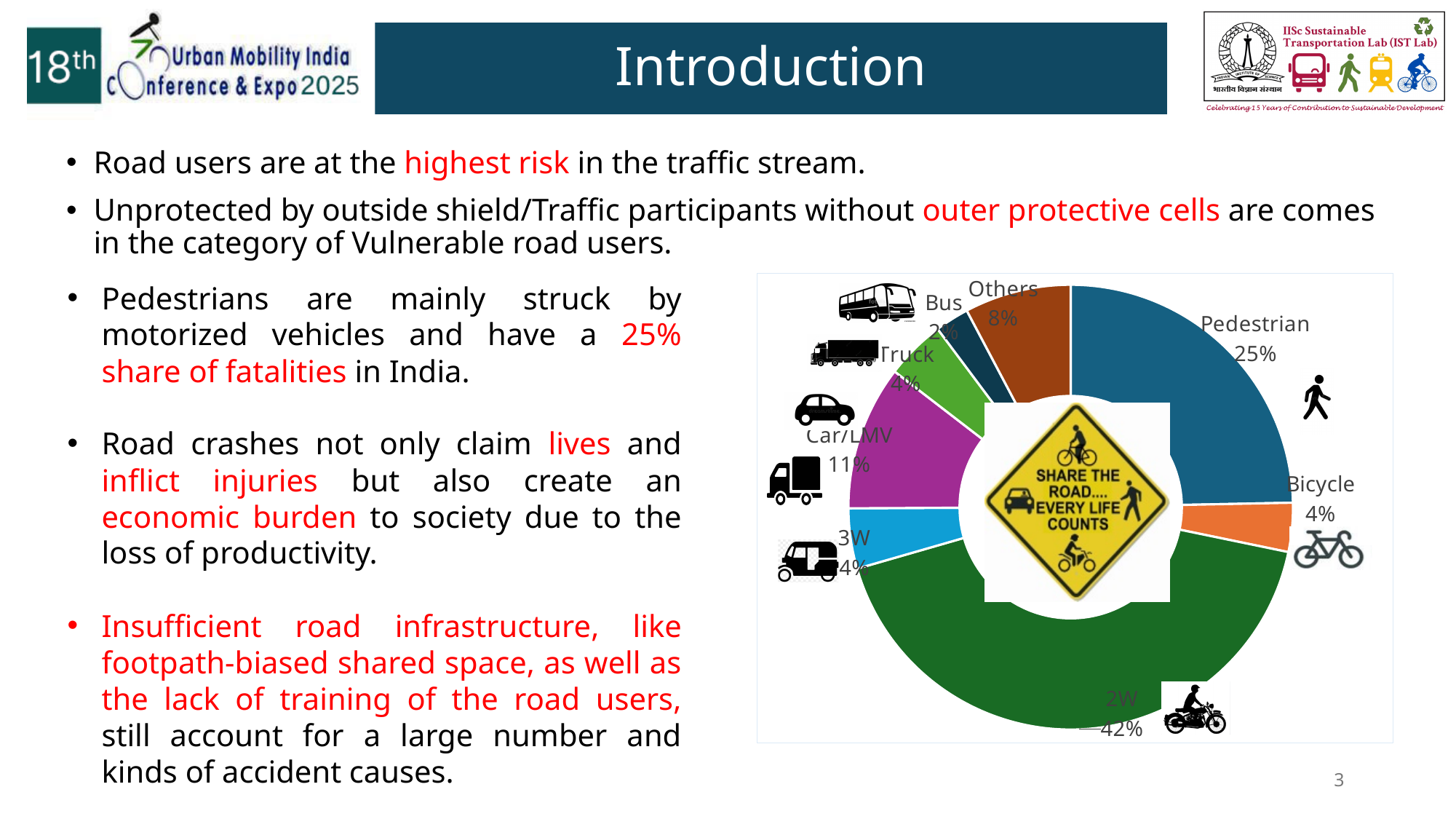
What share of fatalities does the Pedestrian slice of the pie chart show? 25% What percentage is shown for Bicycle in the pie chart? 4% Which has a larger share in the pie chart, Car/LMV or Others? Car/LMV Which category has the largest slice in the pie chart? 2W What percentage is shown for the 2W slice of the pie chart? 42% What percentage is shown for Bus in the pie chart? 2% By how many percentage points does the 2W share exceed the Pedestrian share in the pie chart? 17% How many categories are shown in the pie chart? 8 What percentage is shown for Car/LMV in the pie chart? 11% Which category has the smallest slice in the pie chart? Bus What type of chart is shown on the slide? Doughnut chart What percentage is shown for Others in the pie chart? 8%